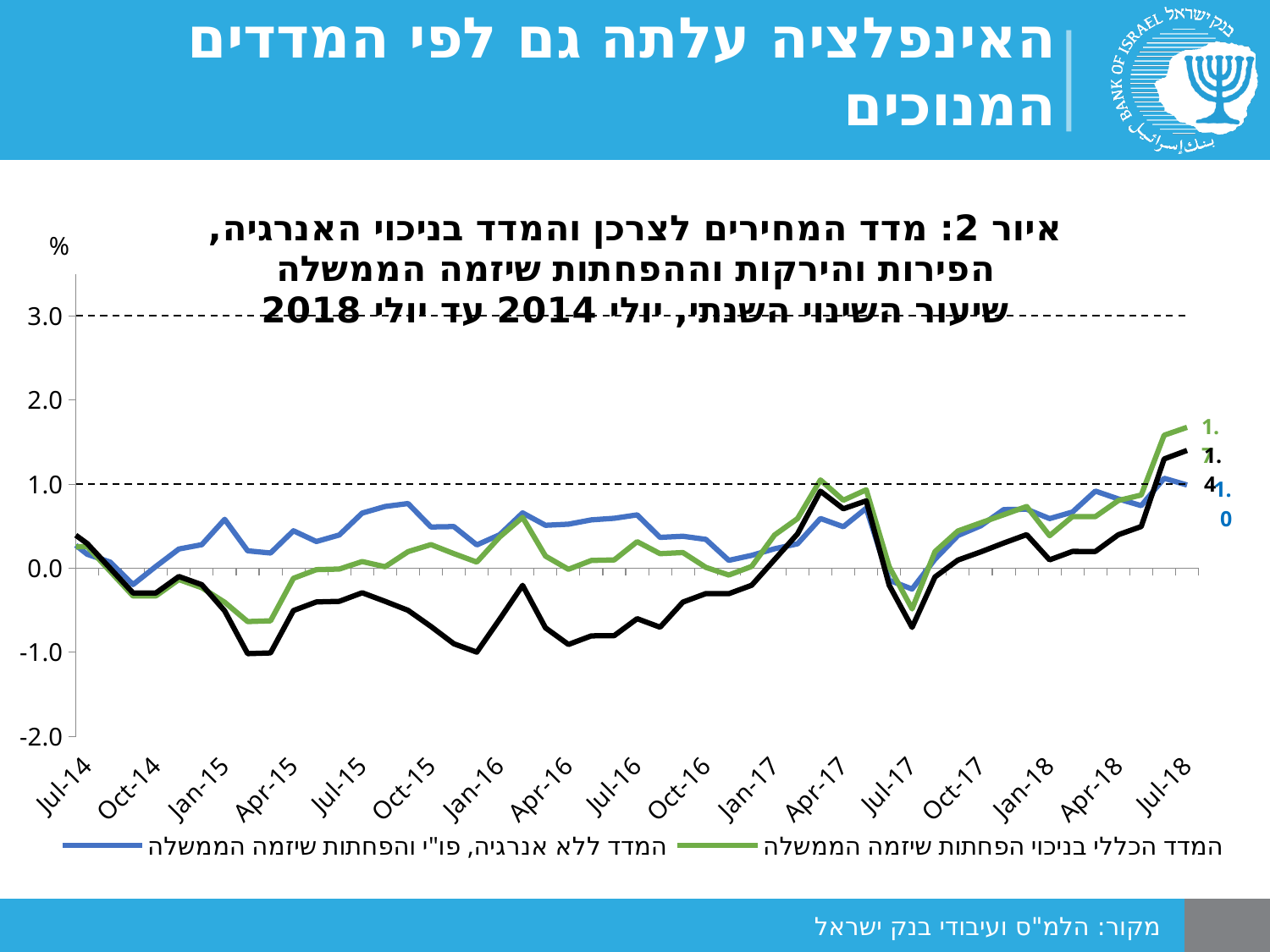
Is the value of the black line at Jul-16 greater or less than 0.0? less What kind of chart is shown on the slide? line chart What unit is shown at the top of the y axis? % How many lines are plotted on the chart? 3 At which two values are the horizontal dashed reference lines drawn? 1.0 and 3.0 Which line has the highest value at Jul-18? the green line Is the value of the black line at Jul-18 greater or less than 1.0? greater Is the value of the green line at Jul-18 greater or less than 1.0? greater Does the green line rise or fall between Jan-18 and Jul-18? rise How many entries does the chart's legend list? 2 Which line has the lowest value at Apr-15? the black line